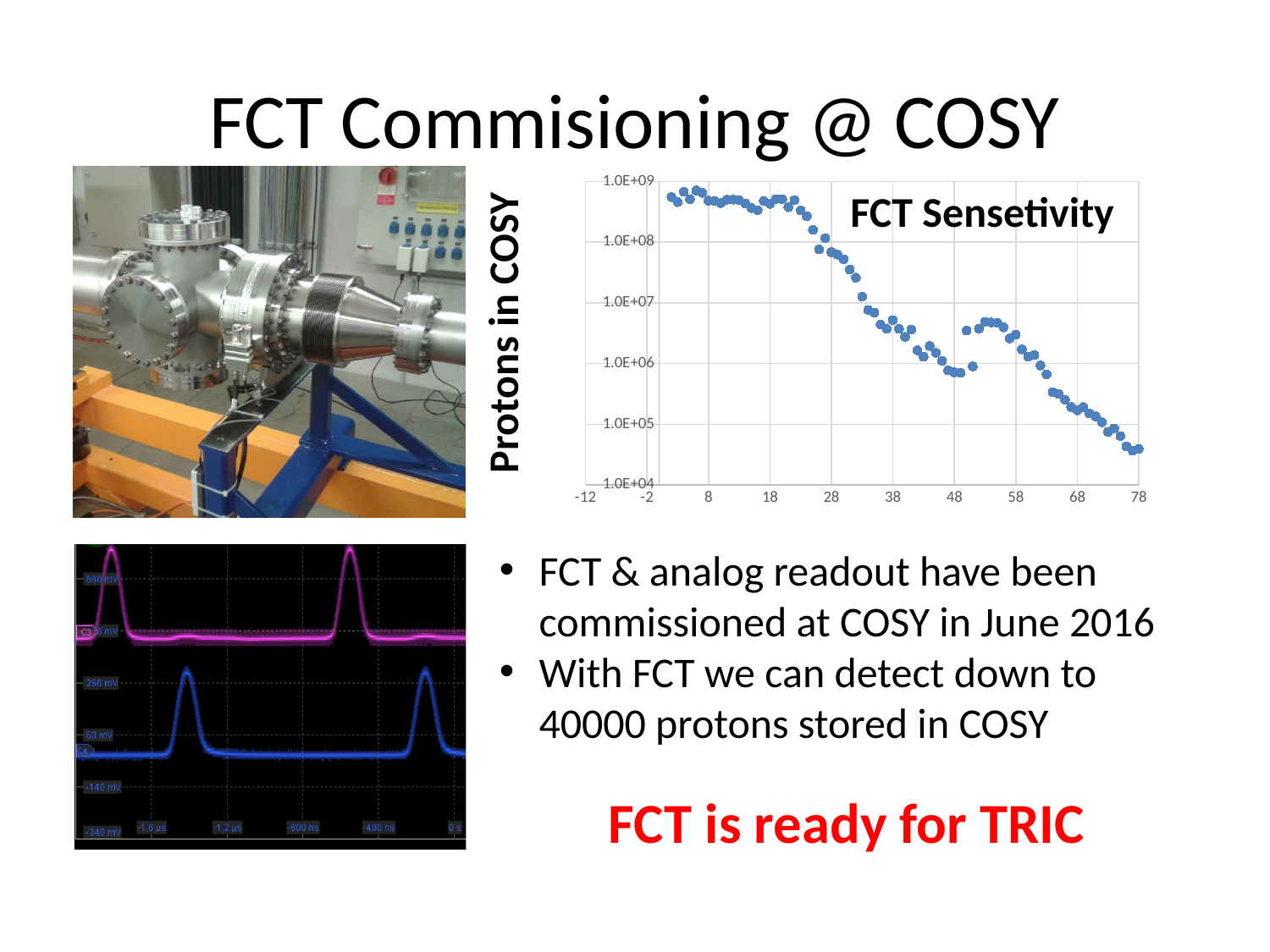
What is the label of the vertical axis of the 'FCT Sensetivity' chart? Protons in COSY In the 'FCT Sensetivity' chart, which has the larger value: the point at x = 8 or the point at x = 68? x = 8 In the 'FCT Sensetivity' chart, is the value at x = 48 greater or less than 1.0E+06? less What is the title of the chart on the slide? FCT Sensetivity In the 'FCT Sensetivity' chart, is the value at x = 38 greater or less than 1.0E+06? greater In the 'FCT Sensetivity' chart, is the value at x = 38 greater or less than 1.0E+07? less In the 'FCT Sensetivity' chart, do the values generally rise or fall as the x value increases? fall In the 'FCT Sensetivity' chart, are the highest values found at the left end or the right end of the x axis? left end In the 'FCT Sensetivity' chart, are the lowest values found at the left end or the right end of the x axis? right end What kind of chart is the 'FCT Sensetivity' chart? scatter chart